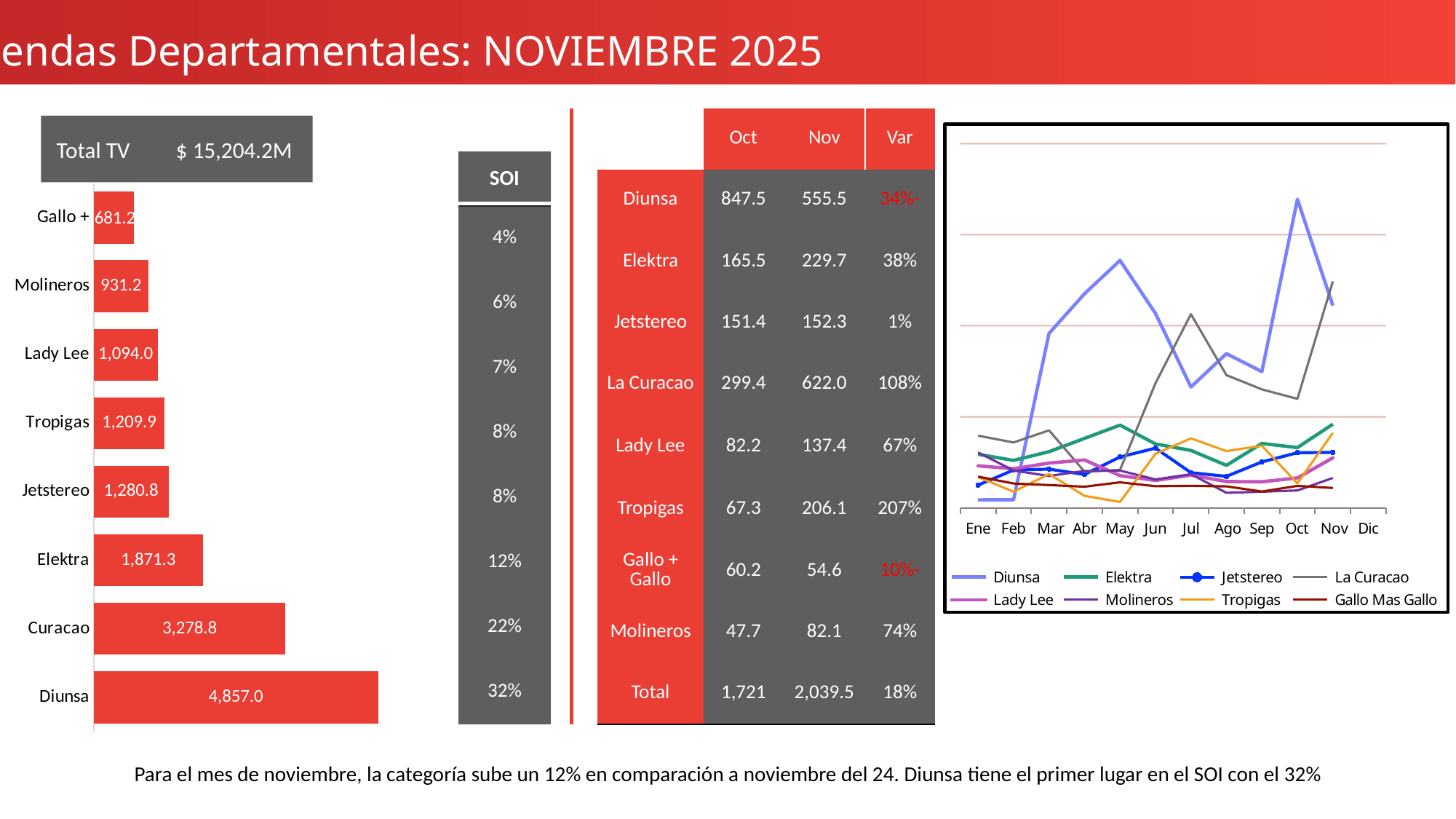
On the bar chart on the left, which category has the lowest value? Gallo + On the bar chart on the left, what is the value for Tropigas? 1,209.9 On the line chart on the right, in which month does the Diunsa line reach its highest point? Oct On the bar chart on the left, which category has the highest value? Diunsa On the bar chart on the left, what is the value for Diunsa? 4,857.0 On the bar chart on the left, what is the difference between the values for Curacao and Elektra? 1,407.5 How many categories does the bar chart on the left show? 8 How many series does the legend of the line chart on the right list? 8 On the bar chart on the left, what is the value for Elektra? 1,871.3 On the bar chart on the left, which is larger, the value for Jetstereo or the value for Lady Lee? Jetstereo What kind of chart is the chart on the right of the slide? Line chart What kind of chart is the chart on the left of the slide? Bar chart